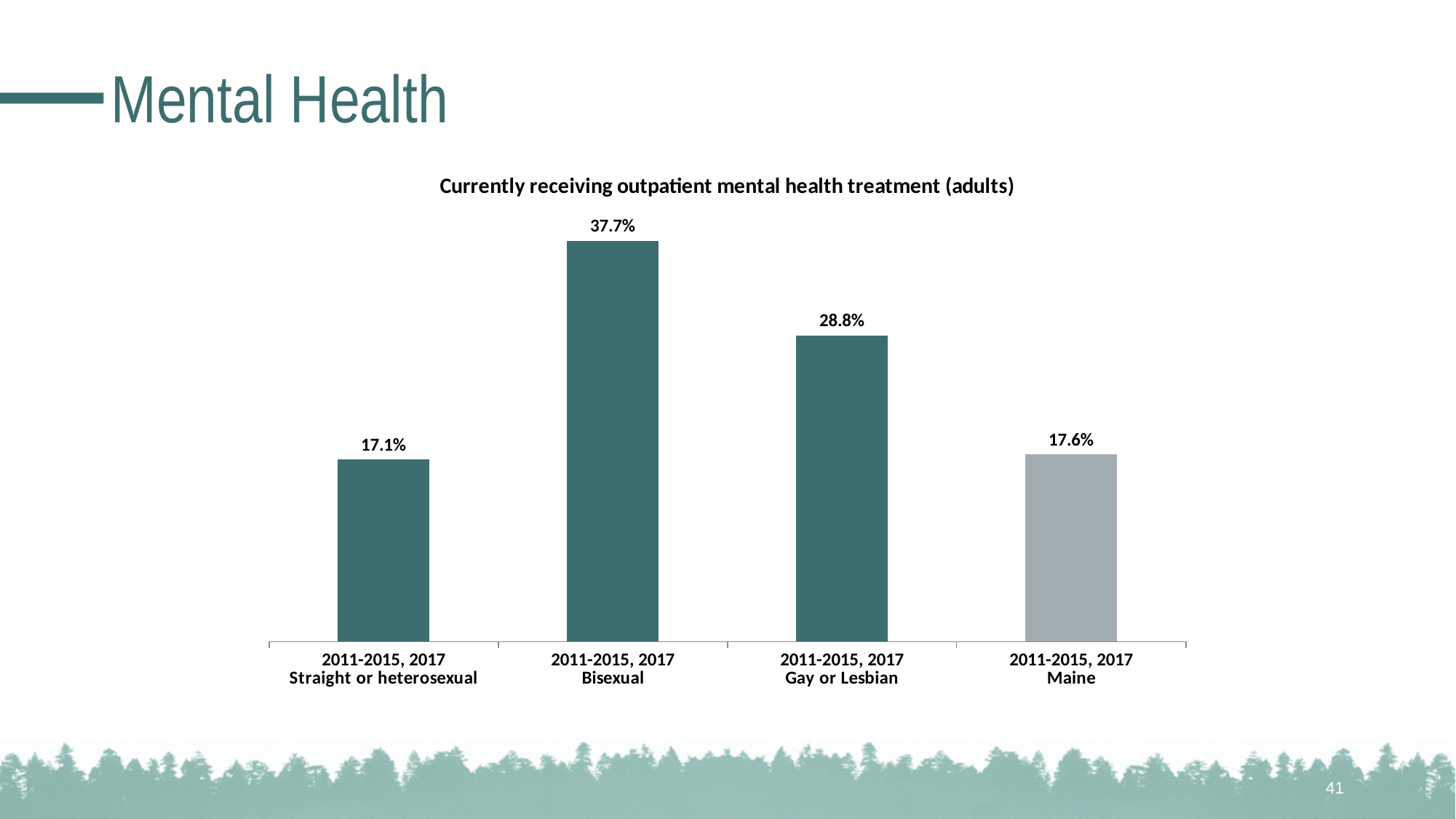
What kind of chart is shown on the slide? Bar chart What is the title of the chart? Currently receiving outpatient mental health treatment (adults) Which category has the highest percentage of adults currently receiving outpatient mental health treatment? Bisexual What is the value for Straight or heterosexual adults currently receiving outpatient mental health treatment? 17.1% What is the value for Gay or Lesbian adults currently receiving outpatient mental health treatment? 28.8% Which category has the lowest percentage of adults currently receiving outpatient mental health treatment? Straight or heterosexual What is the value for Bisexual adults currently receiving outpatient mental health treatment? 37.7% What is the difference between the Maine and Straight or heterosexual values? 0.5% What is the value for Maine adults currently receiving outpatient mental health treatment? 17.6% What is the difference between the Bisexual and Gay or Lesbian values? 8.9% How many categories are shown in the chart? 4 Which is larger, the value for Gay or Lesbian or the value for Maine? Gay or Lesbian